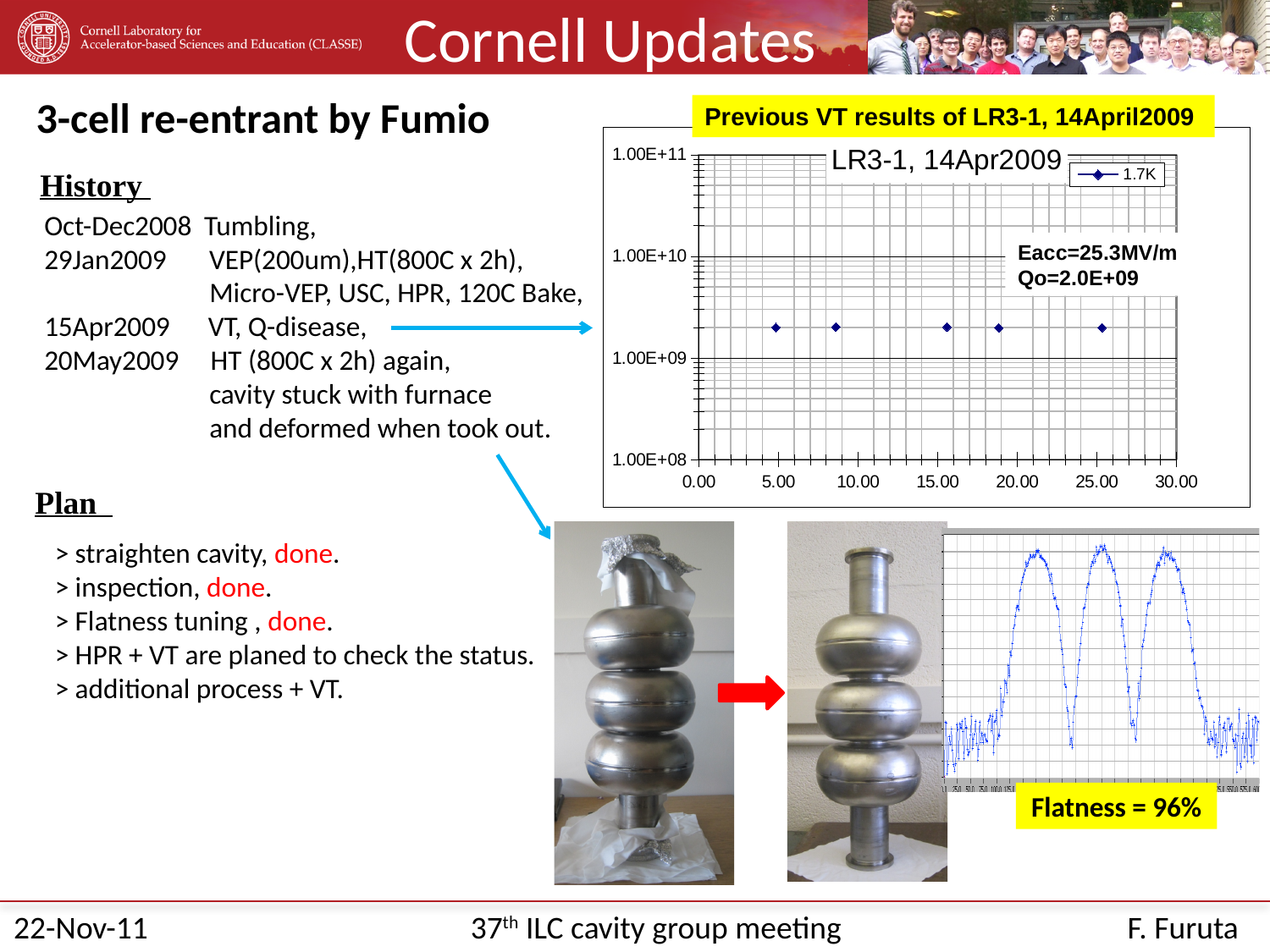
On the chart titled 'LR3-1, 14Apr2009', how many data points are plotted? 5 On the flatness plot at the lower right of the slide, what flatness value is printed? Flatness = 96% On the chart titled 'LR3-1, 14Apr2009', how many series does the legend list? 1 On the chart titled 'LR3-1, 14Apr2009', what is the highest tick label on the x axis? 30.00 On the chart titled 'LR3-1, 14Apr2009', what Eacc value is annotated on the chart? Eacc=25.3MV/m On the chart titled 'LR3-1, 14Apr2009', what is the legend entry? 1.7K On the chart titled 'LR3-1, 14Apr2009', is the value of the data point near 5 on the x axis greater or less than 1.00E+09? greater On the chart titled 'LR3-1, 14Apr2009', what kind of chart is it? scatter chart On the chart titled 'LR3-1, 14Apr2009', do the plotted values rise, fall, or stay roughly flat as the x value increases? roughly flat On the chart titled 'LR3-1, 14Apr2009', what Qo value is annotated on the chart? Qo=2.0E+09 On the chart titled 'LR3-1, 14Apr2009', is the value of the data point near 25 on the x axis greater or less than 1.00E+10? less